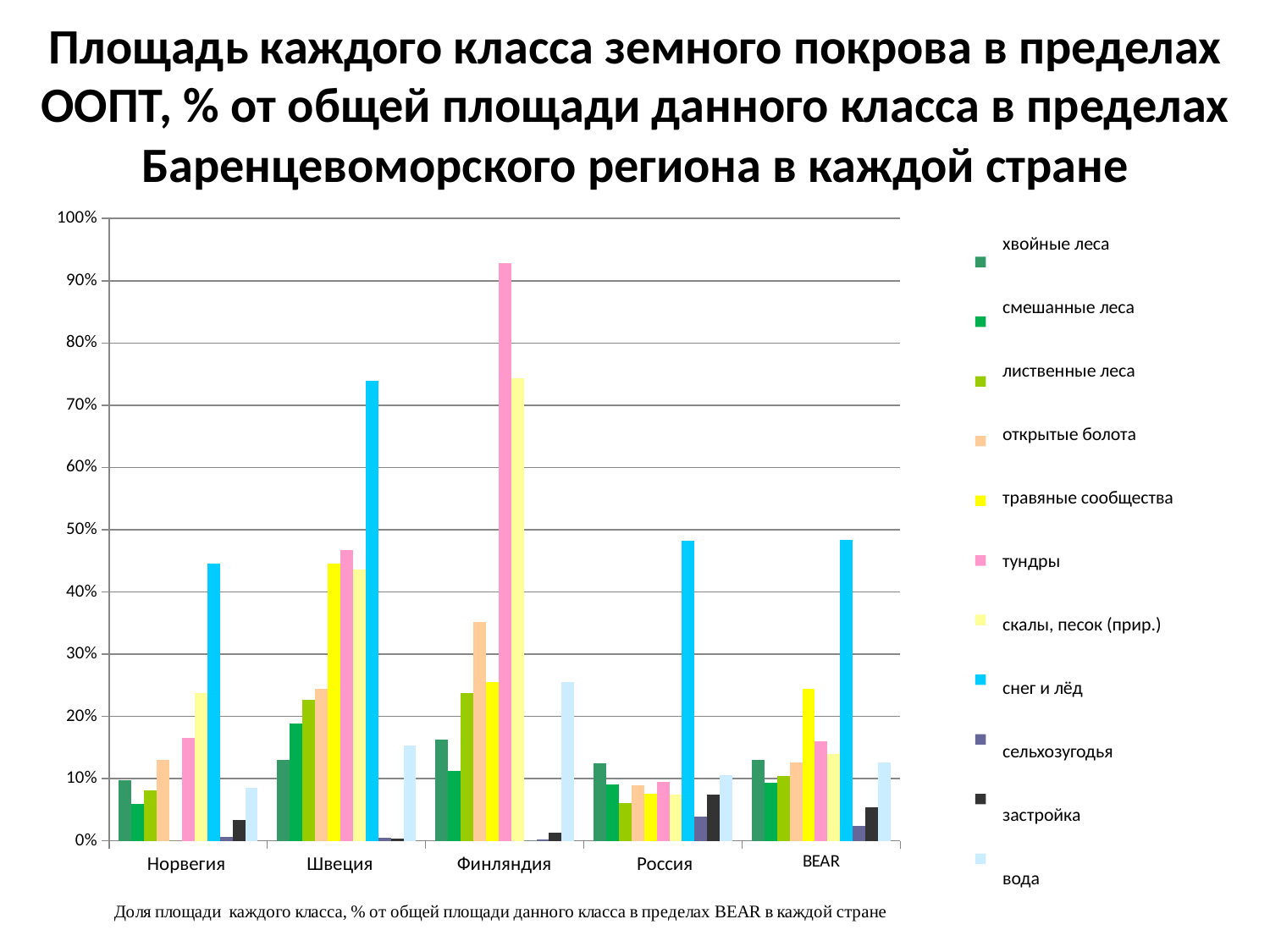
Is the value for открытые болота in Финляндия greater or less than 30%? greater How many land cover classes does the legend list? 11 Is the value for снег и лёд in Швеция greater or less than 70%? greater Which is larger: the value for снег и лёд in Швеция or in Норвегия? Швеция Is the value for тундры in Финляндия greater or less than 90%? greater Which land cover class has the highest bar for Финляндия? тундры How many countries/regions are shown along the x axis? 5 What kind of chart is shown on the slide? bar chart Which is larger: the value for тундры in Финляндия or in Швеция? Финляндия Which land cover class has the highest bar for Россия? снег и лёд Which land cover class has the highest bar for Норвегия? снег и лёд